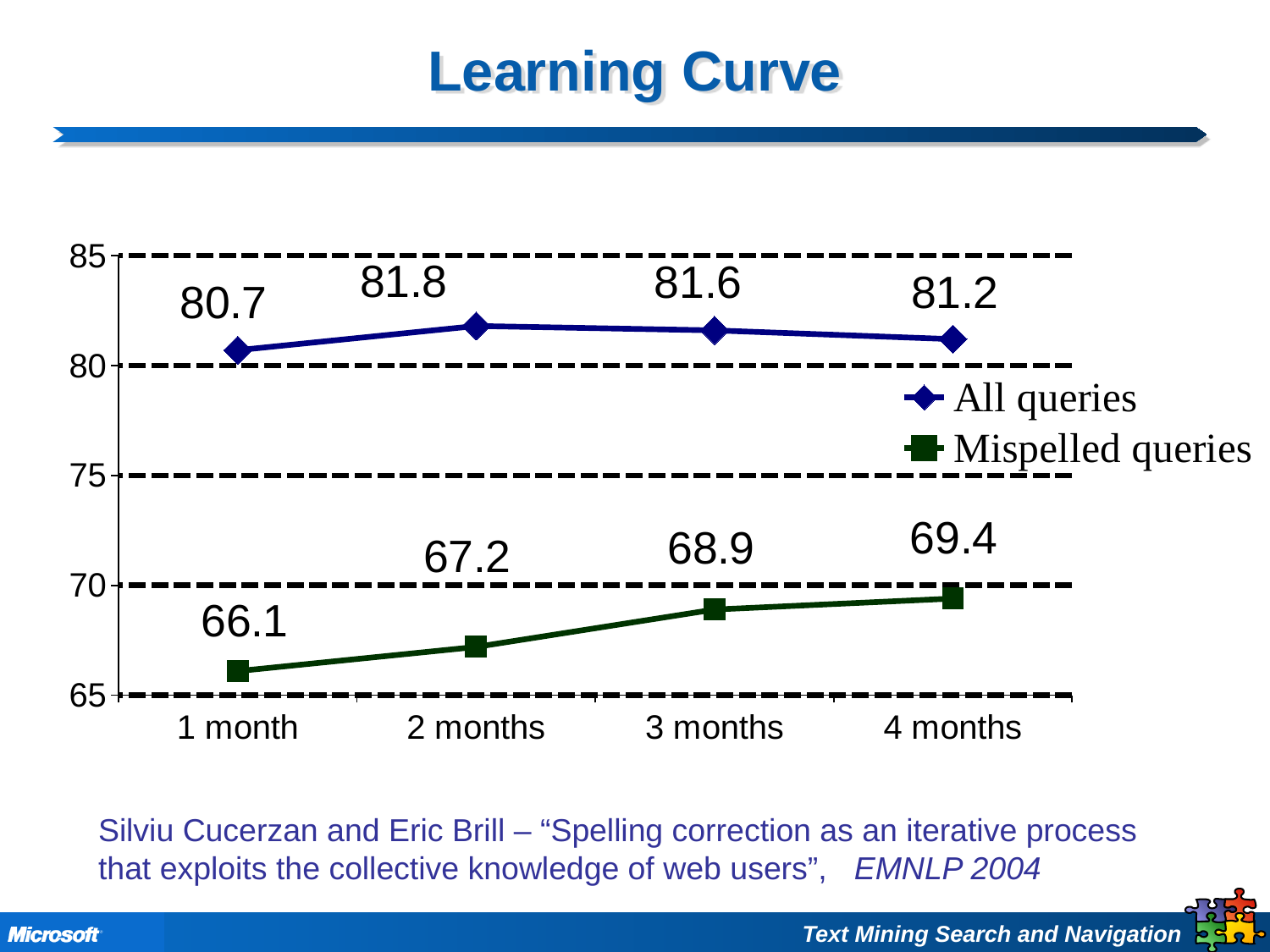
How many series does the legend list? 2 What is the value for All queries at 2 months? 81.8 What is the value for Mispelled queries at 4 months? 69.4 How many time points are plotted on the x axis? 4 At which time point is the Mispelled queries value lowest? 1 month Do the Mispelled queries values rise or fall from 1 month to 4 months? rise What is the difference between the All queries and Mispelled queries values at 4 months? 11.8 What is the value for Mispelled queries at 1 month? 66.1 Which is larger: the Mispelled queries value at 3 months or at 2 months? 3 months Is the value for Mispelled queries at 4 months greater or less than 70? less What kind of chart is shown on the slide? line chart At which time point is the All queries value highest? 2 months